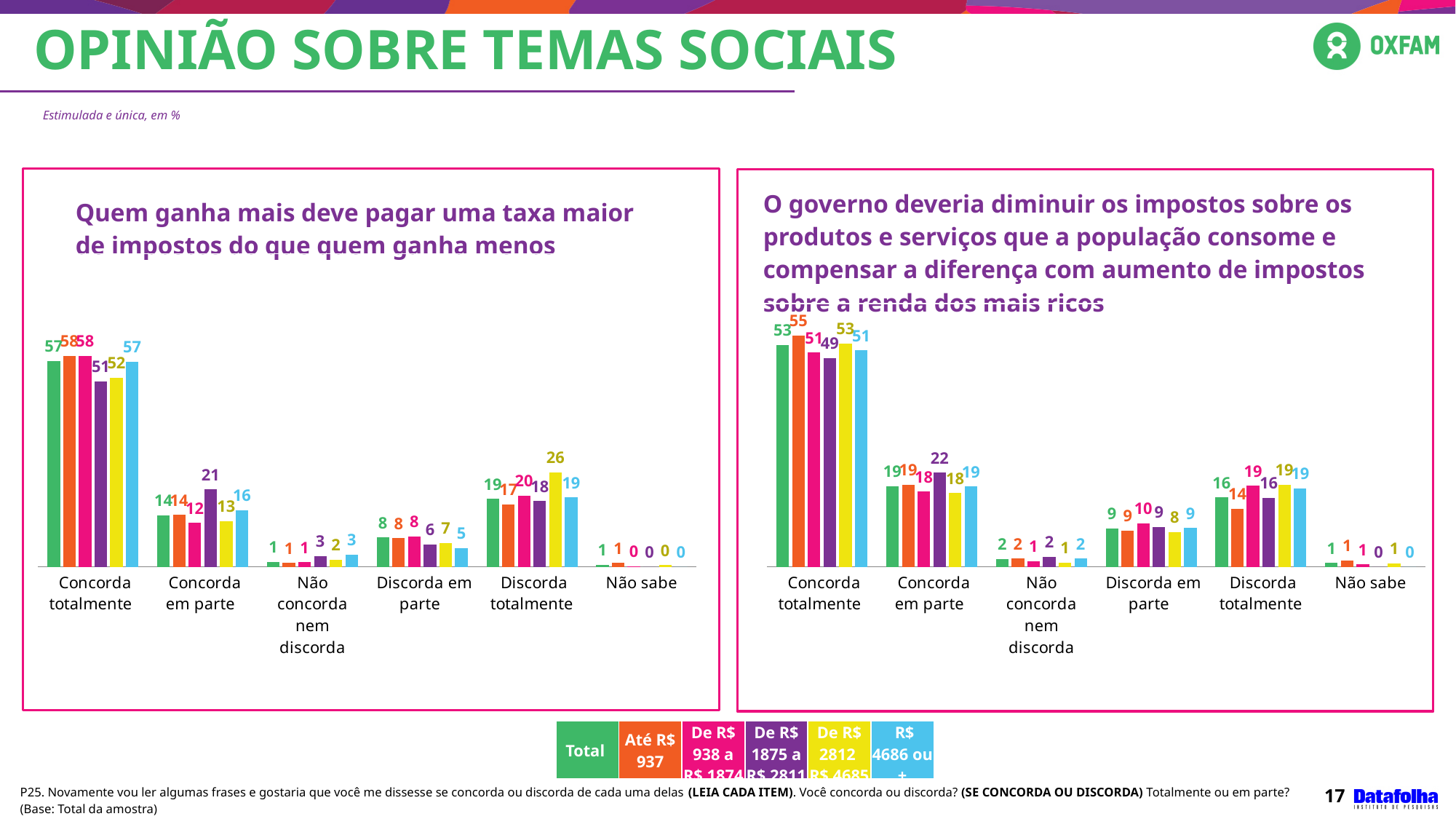
In the left chart ("Quem ganha mais deve pagar..."), what is the difference between the Total values for "Concorda totalmente" and "Discorda totalmente"? 38 What type of chart is used in the right chart ("O governo deveria diminuir os impostos...")? bar chart How many response categories are shown on the x axis of the left chart? 6 In the left chart ("Quem ganha mais deve pagar..."), what is the value for "De R$ 1875 a R$ 2811" in the "Concorda em parte" category? 21 How many series does the legend list for the charts on this slide? 6 In the right chart ("O governo deveria diminuir os impostos..."), what is the Total value for "Discorda em parte"? 9 In the left chart ("Quem ganha mais deve pagar..."), which income group has the highest value for "Discorda totalmente"? De R$ 2812 a R$ 4685 In the right chart ("O governo deveria diminuir os impostos..."), what is the value for "Até R$ 937" in the "Concorda totalmente" category? 55 In the left chart ("Quem ganha mais deve pagar uma taxa maior de impostos do que quem ganha menos"), what is the Total value for "Concorda totalmente"? 57 In the right chart ("O governo deveria diminuir os impostos..."), which income group has the lowest value for "Concorda totalmente"? De R$ 1875 a R$ 2811 In the right chart ("O governo deveria diminuir os impostos..."), is the Total value for "Discorda totalmente" larger or smaller than the Total value for "Concorda em parte"? smaller Which colour represents the "Total" series in the legend? green